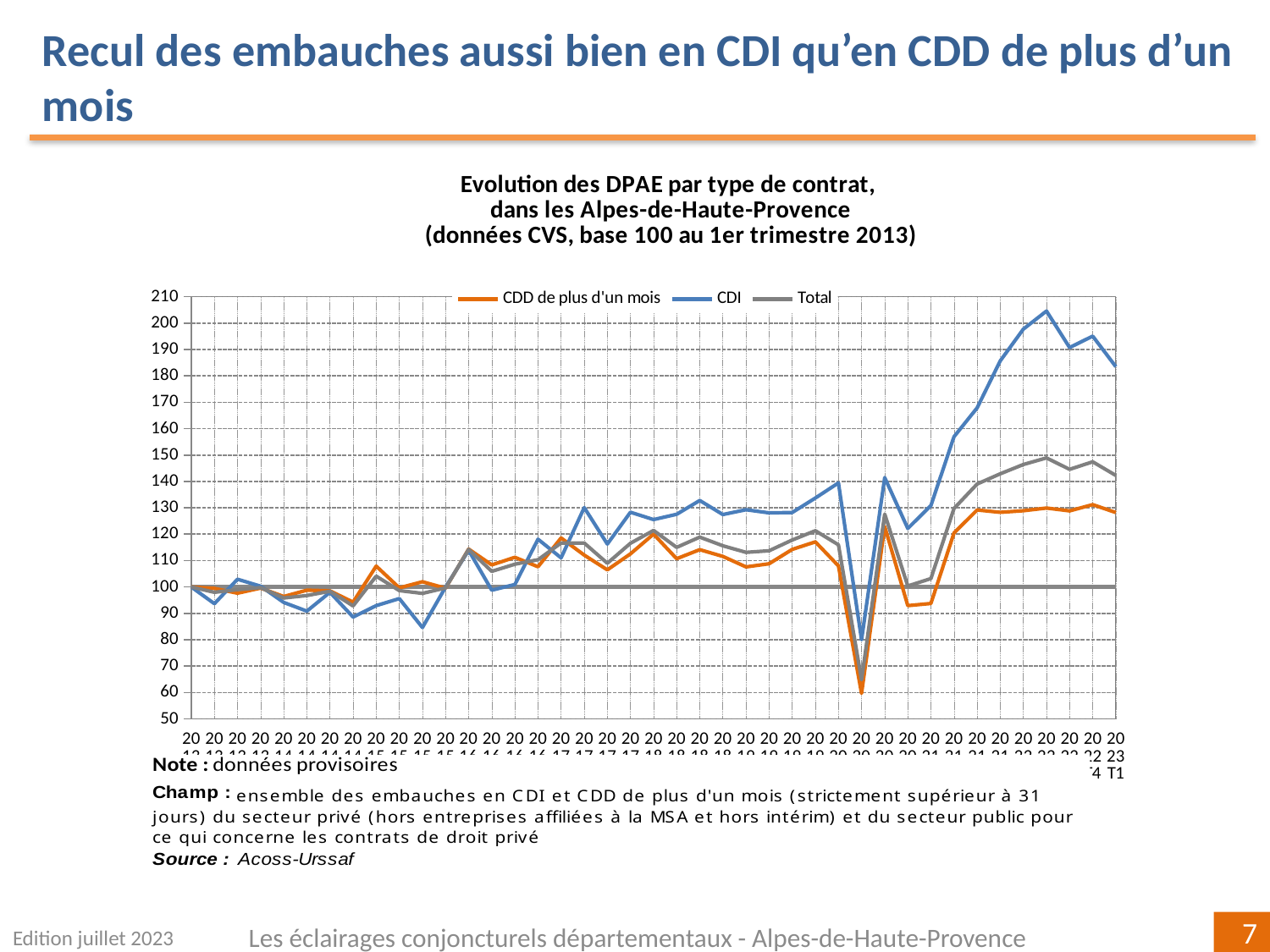
Is the peak value of the CDI series greater or less than 200? greater Which series reaches the highest value anywhere on the chart? CDI Which series falls to the lowest value anywhere on the chart? CDD de plus d'un mois How many series does the chart legend list? 3 Is the lowest value of the CDD de plus d'un mois series greater or less than 70? less Over the whole period shown, do the CDI values generally rise or fall? rise What is the base period stated in the chart title? 1er trimestre 2013 What are the three series named in the chart legend? CDD de plus d'un mois, CDI, Total Is the CDI value at the last point (23 T1) greater or less than 170? greater At the last point (23 T1), which series is higher, CDI or Total? CDI What kind of chart is shown on the slide? line chart